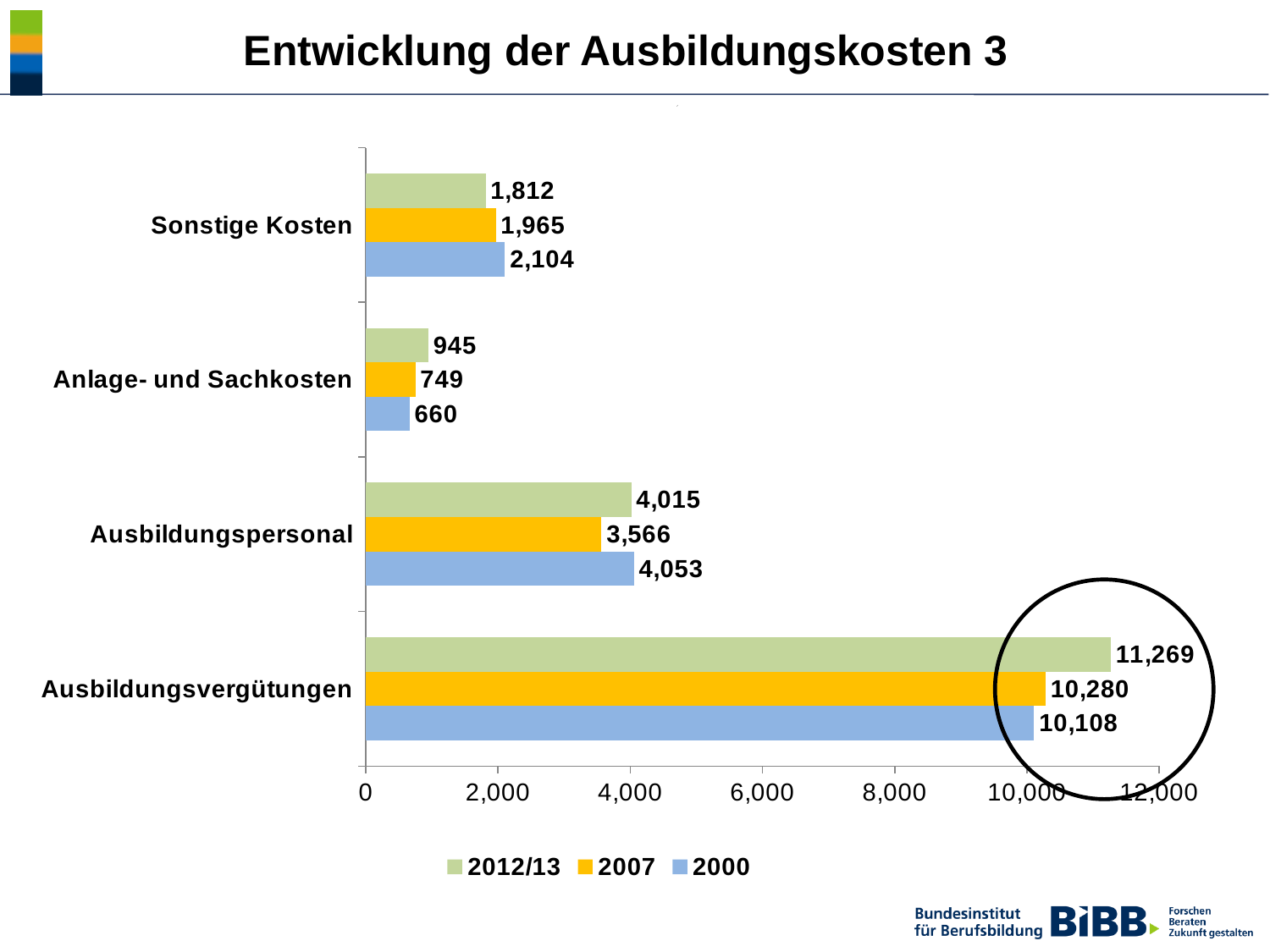
Which category has the lowest value in the 2012/13 series? Anlage- und Sachkosten What is the value for Ausbildungsvergütungen in the 2012/13 series? 11,269 Which category has the highest value in the 2007 series? Ausbildungsvergütungen What kind of chart is shown on the slide? bar chart What is the value for Sonstige Kosten in the 2007 series? 1,965 Which colour represents the 2007 series in the legend? yellow What is the value for Anlage- und Sachkosten in the 2000 series? 660 How many categories are shown on the chart? 4 Which is larger for Ausbildungspersonal: the 2007 value or the 2000 value? 2000 Is the 2012/13 value for Ausbildungsvergütungen greater or less than 10,000? greater What is the difference between the 2012/13 and 2000 values for Ausbildungsvergütungen? 1,161 How many series does the legend list? 3